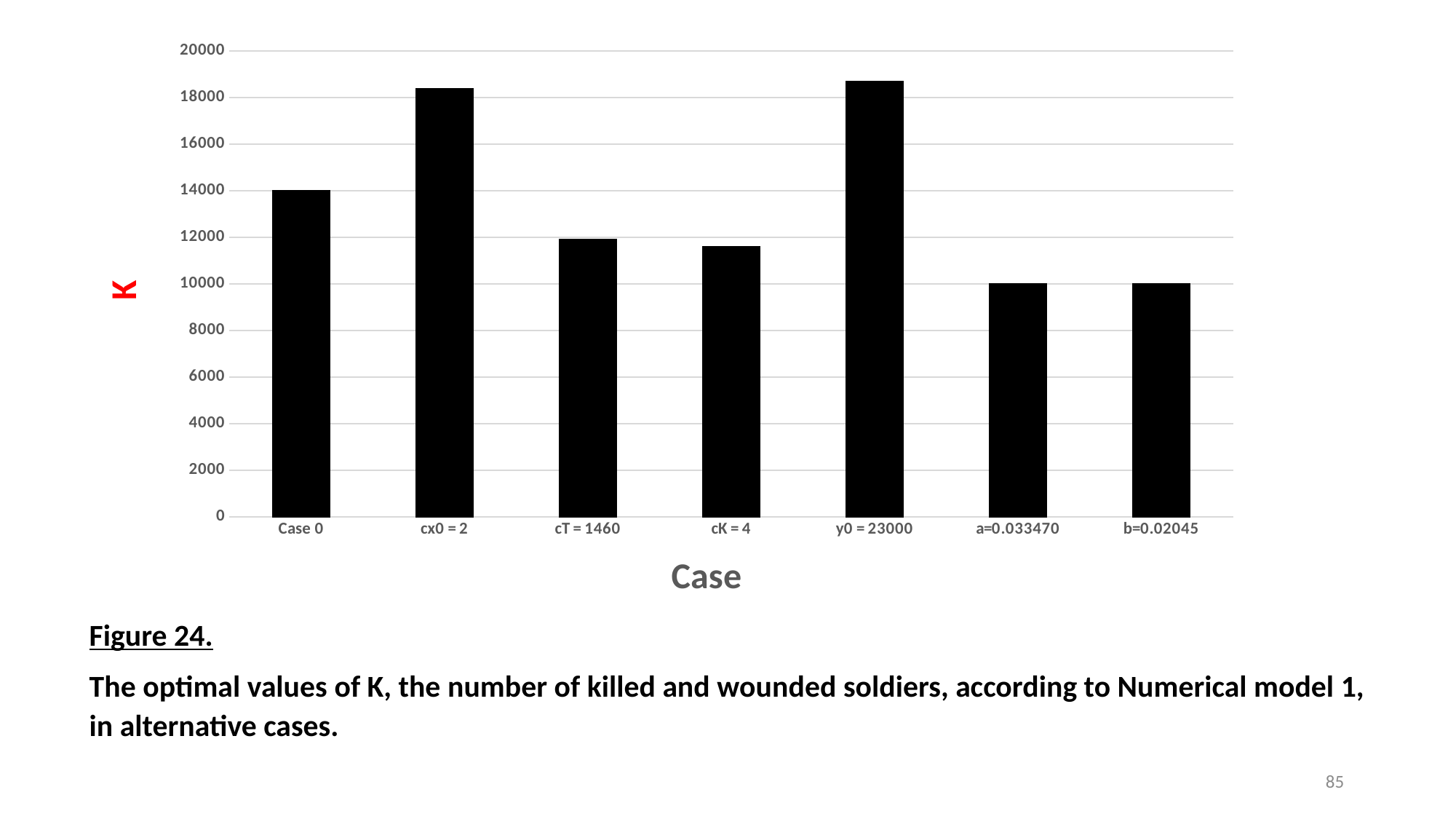
Which has a larger value of K, Case 0 or cT = 1460? Case 0 What is the title of the x axis? Case Is the value of K for cT = 1460 greater or less than 10000? greater Which case has the highest value of K? y0 = 23000 Is the value of K for cK = 4 greater or less than 12000? less What label is shown on the y axis? K Is the value of K for y0 = 23000 greater or less than 18000? greater What kind of chart is shown on the slide? bar chart Which has a larger value of K, cx0 = 2 or a=0.033470? cx0 = 2 How many cases (bars) are plotted on the chart? 7